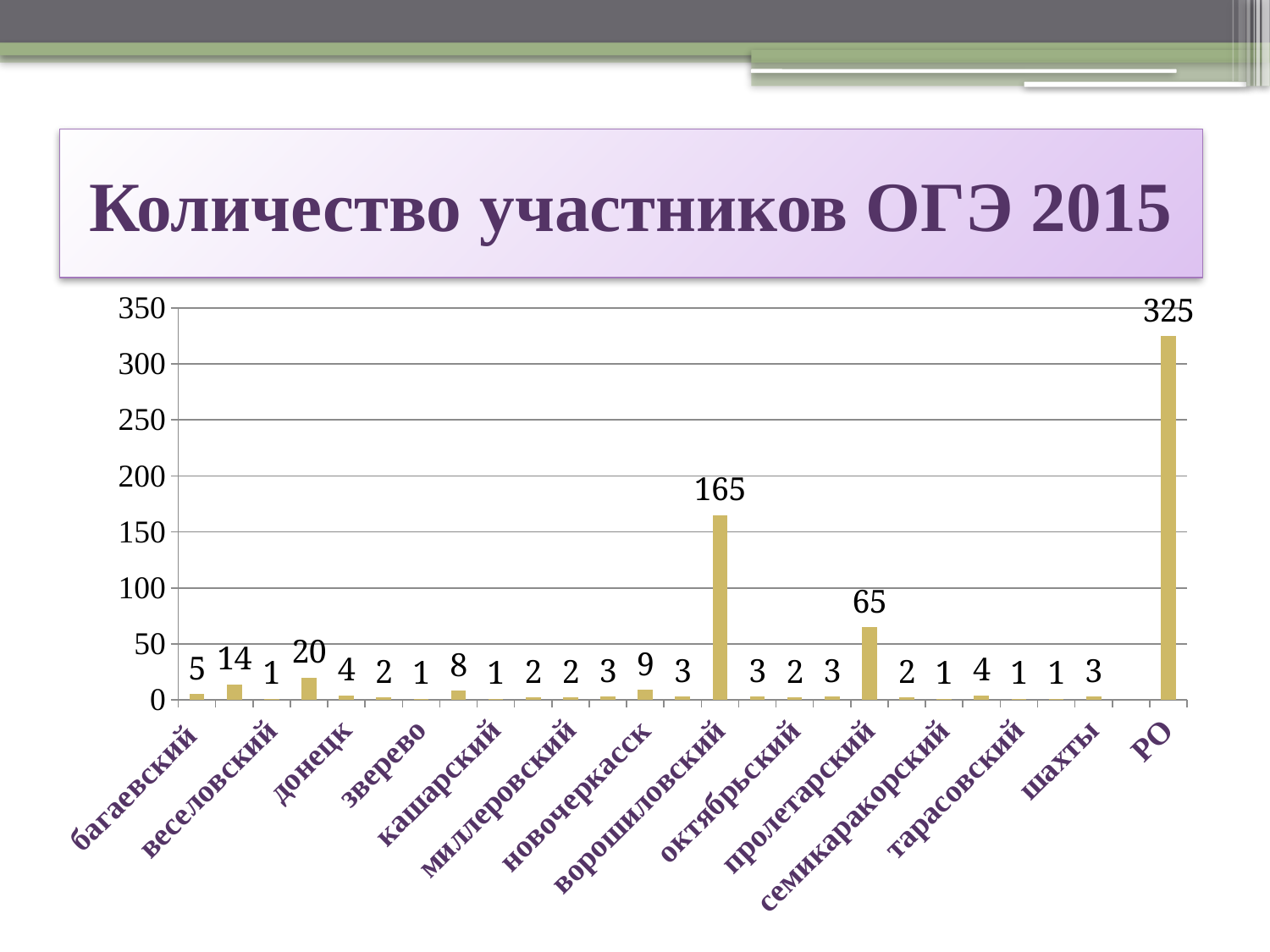
What is the value for ворошиловский? 165 What is the value for пролетарский? 65 What is the difference between the values for РО and ворошиловский? 160 What kind of chart is shown on the slide? bar chart Is the value for ворошиловский greater or less than 150? greater What is the difference between the values for ворошиловский and пролетарский? 100 What is the value for РО? 325 Which is larger, the value for ворошиловский or the value for пролетарский? ворошиловский Is the value for пролетарский greater or less than 100? less What is the value for багаевский? 5 What is the title of the slide? Количество участников ОГЭ 2015 Which category has the highest number of participants? РО